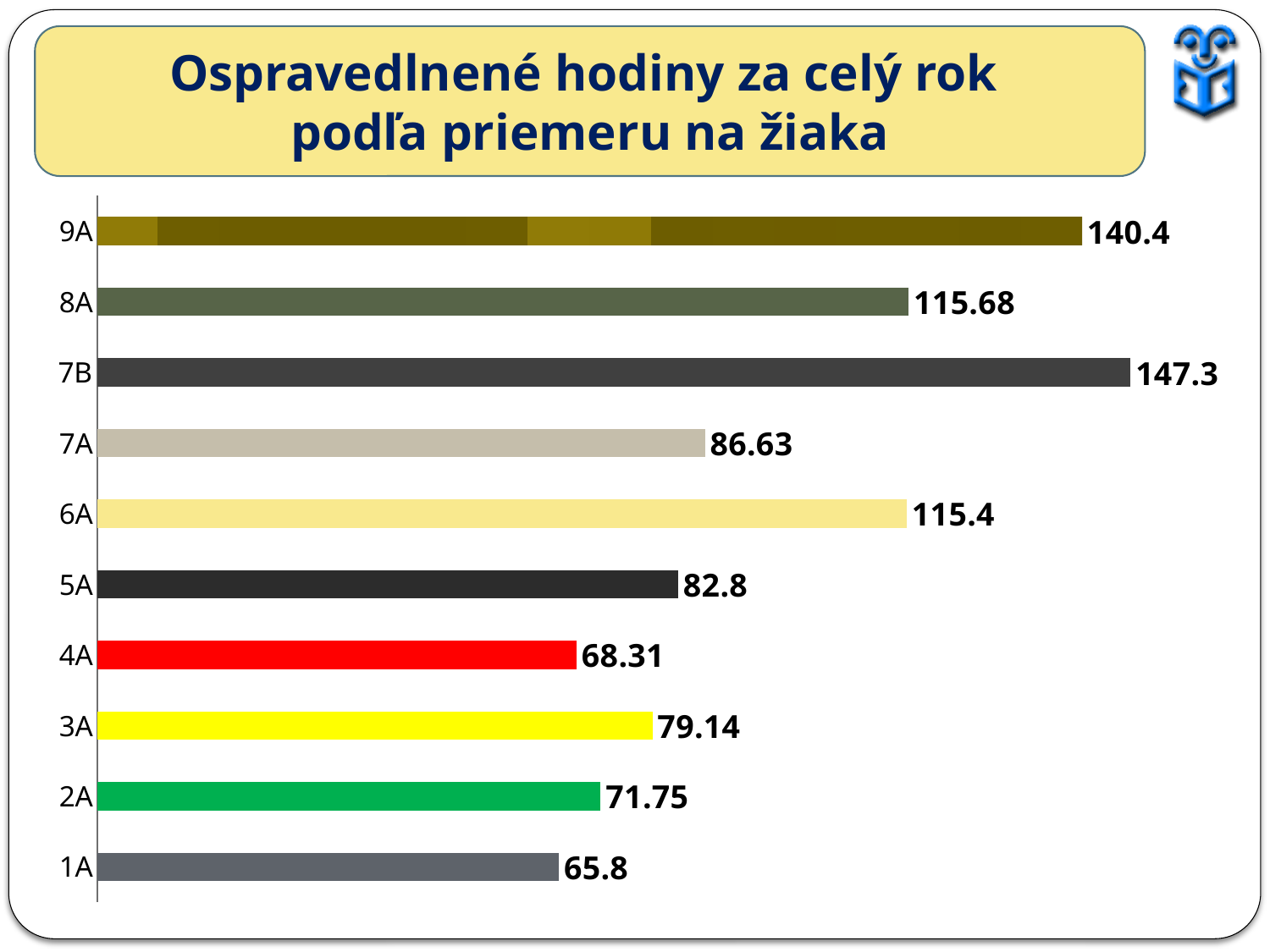
Which class has the highest value? 7B What is the title of the slide? Ospravedlnené hodiny za celý rok podľa priemeru na žiaka Which is larger, the value for 7A or the value for 5A? 7A What is the value for class 1A? 65.8 What is the value for class 7B? 147.3 How many classes are shown in the chart? 10 Which class has the lowest value? 1A What is the value for class 6A? 115.4 What is the value for class 4A? 68.31 What is the difference between the values for 7B and 9A? 6.9 What kind of chart is shown on the slide? Bar chart What is the difference between the values for 3A and 2A? 7.39